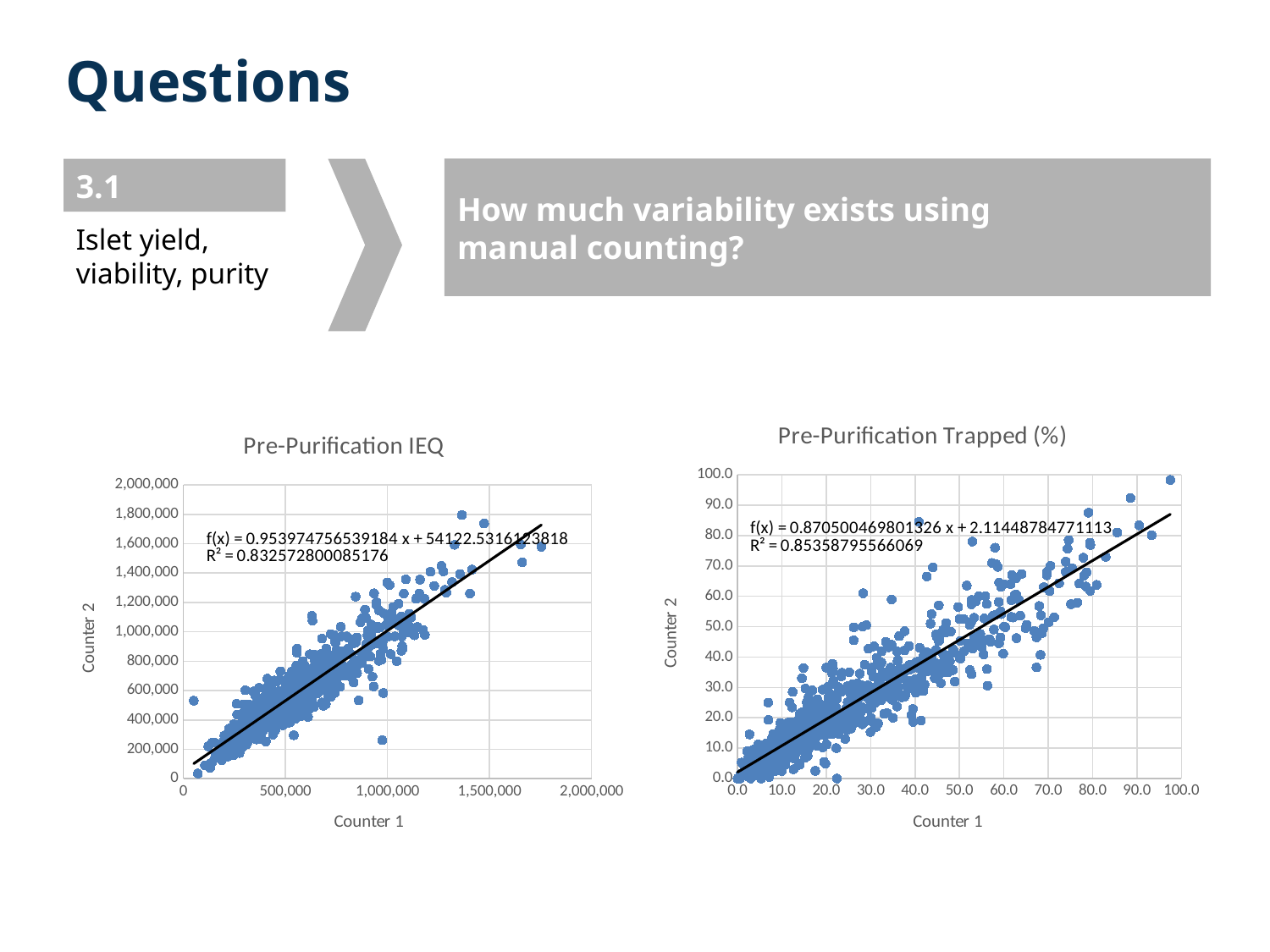
What is the intercept of the trend line equation shown on the 'Pre-Purification Trapped (%)' chart? 2.11448784771113 In the 'Pre-Purification IEQ' chart, do the Counter 2 values generally rise or fall as Counter 1 increases? rise In the 'Pre-Purification Trapped (%)' chart, do the Counter 2 values generally rise or fall as Counter 1 increases? rise What kind of chart is the 'Pre-Purification Trapped (%)' chart? scatter chart What kind of chart is the 'Pre-Purification IEQ' chart? scatter chart What is the highest tick value shown on the y axis of the 'Pre-Purification IEQ' chart? 2,000,000 Which chart has the higher R² value, 'Pre-Purification IEQ' or 'Pre-Purification Trapped (%)'? Pre-Purification Trapped (%) What is the R² value shown on the 'Pre-Purification IEQ' chart? 0.832572800085176 What is the R² value shown on the 'Pre-Purification Trapped (%)' chart? 0.85358795566069 What is the slope of the trend line equation shown on the 'Pre-Purification IEQ' chart? 0.953974756539184 What is the label of the x axis on the 'Pre-Purification IEQ' chart? Counter 1 What is the label of the y axis on the 'Pre-Purification Trapped (%)' chart? Counter 2